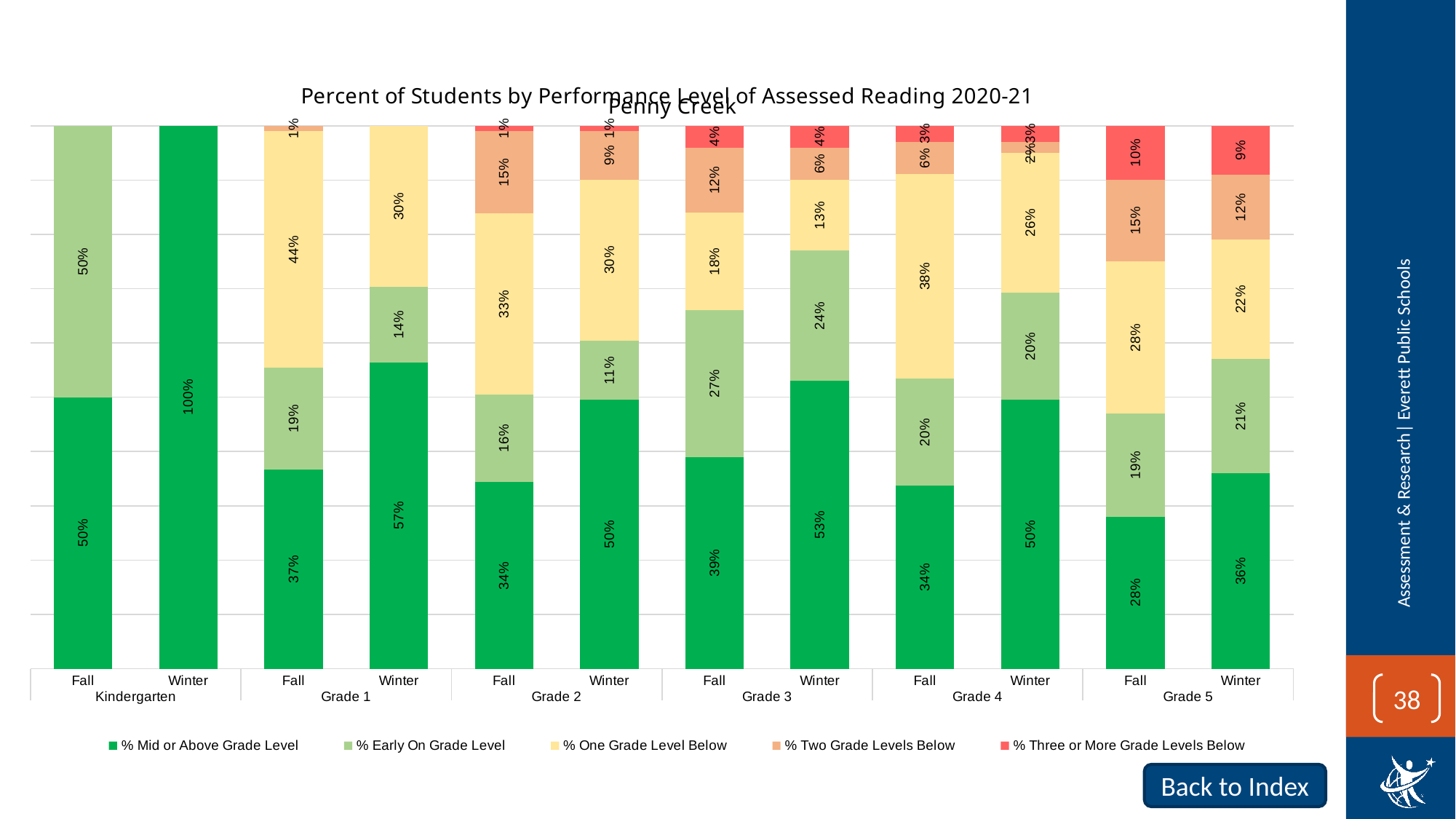
How many bars are plotted in the chart? 12 Which series is shown in dark green in the legend? % Mid or Above Grade Level Which bar has the highest % Mid or Above Grade Level value? Kindergarten Winter What is the % One Grade Level Below value for Grade 4 Fall? 38% Which is larger: the % Early On Grade Level value for Grade 3 Fall or for Grade 2 Fall? Grade 3 Fall Which bar has the lowest % Mid or Above Grade Level value? Grade 5 Fall How many series does the legend list? 5 What kind of chart is shown on the slide? Stacked bar chart What is the % Three or More Grade Levels Below value for Grade 5 Fall? 10% What is the difference between the % Mid or Above Grade Level values for Grade 3 Winter and Grade 3 Fall? 14% What is the % Mid or Above Grade Level value for Grade 1 Winter? 57% What is the % Two Grade Levels Below value for Grade 2 Fall? 15%